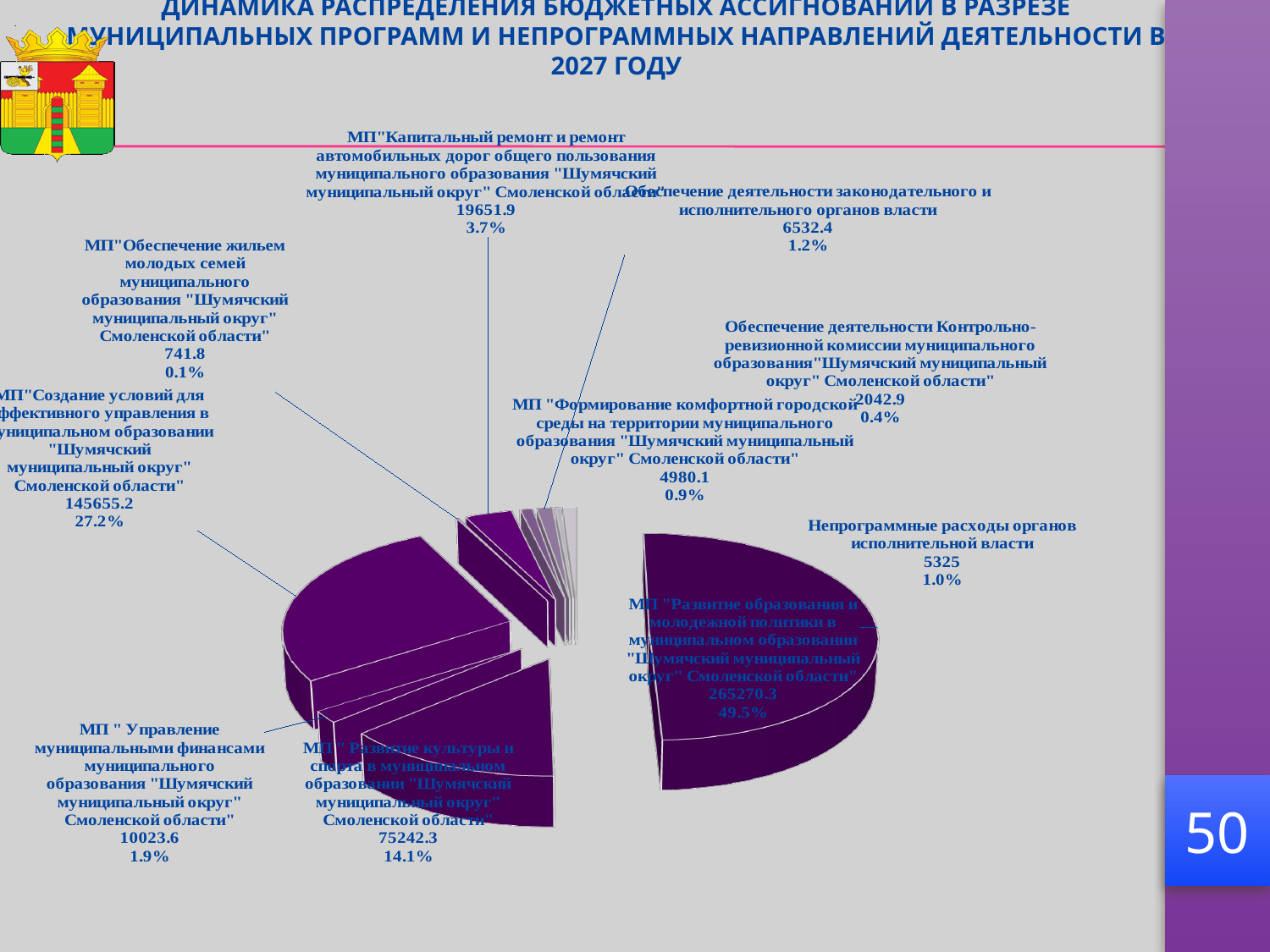
What is the value for МП "Развитие образования и молодежной политики"? 265270.3 What kind of chart is shown on the slide? pie chart Which is larger: the value for МП "Капитальный ремонт и ремонт автомобильных дорог" or the value for МП "Формирование комфортной городской среды"? МП "Капитальный ремонт и ремонт автомобильных дорог" What share of the pie does МП "Развитие культуры и спорта" represent? 14.1% Which category has the largest slice of the pie? МП "Развитие образования и молодежной политики" What is the value for Обеспечение деятельности Контрольно-ревизионной комиссии? 2042.9 What is the value for МП "Создание условий для эффективного управления"? 145655.2 How many categories (slices) does the pie chart show? 10 What share of the pie does Непрограммные расходы органов исполнительной власти represent? 1.0% What is the difference between the values for МП "Управление муниципальными финансами" (10023.6) and Обеспечение деятельности законодательного и исполнительного органов власти (6532.4)? 3491.2 Which year does the chart title refer to? 2027 Which category has the smallest slice of the pie? МП "Обеспечение жильем молодых семей"